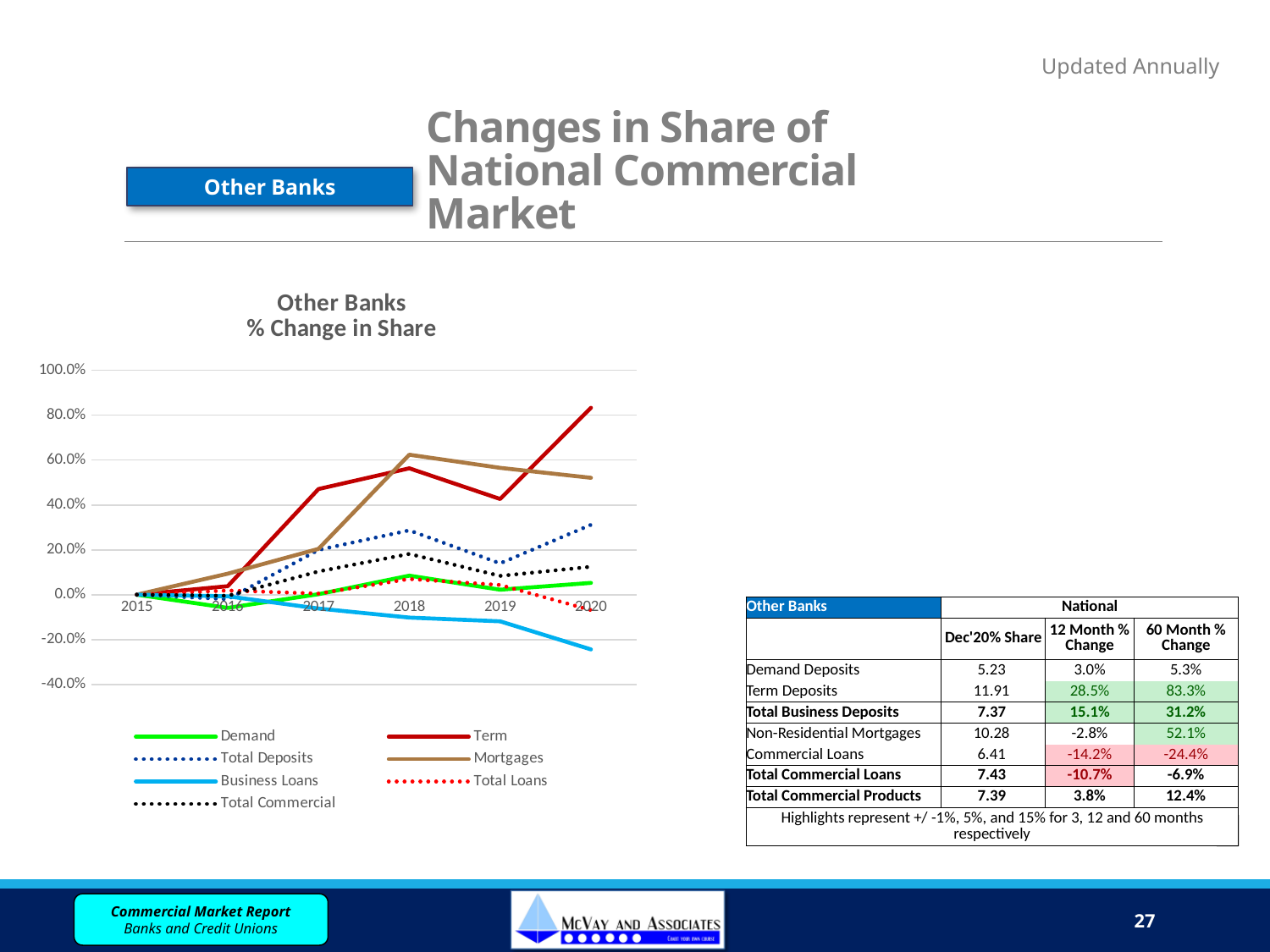
Is the value for Term in 2020 greater or less than 60.0%? greater How many years are shown on the x axis of the chart? 6 Which series has the highest value in 2020? Term What kind of chart is shown on the slide? line chart What is the title of the chart? Other Banks % Change in Share Is the value for Business Loans in 2020 greater or less than -20.0%? less Is the value for Mortgages in 2020 greater or less than 40.0%? greater Does the Business Loans series rise or fall from 2015 to 2020? fall How many series does the legend of the "Other Banks % Change in Share" chart list? 7 Which series has the highest value in 2018? Mortgages Which series has the lowest value in 2020? Business Loans In 2020, which is larger: the value for Term or the value for Mortgages? Term